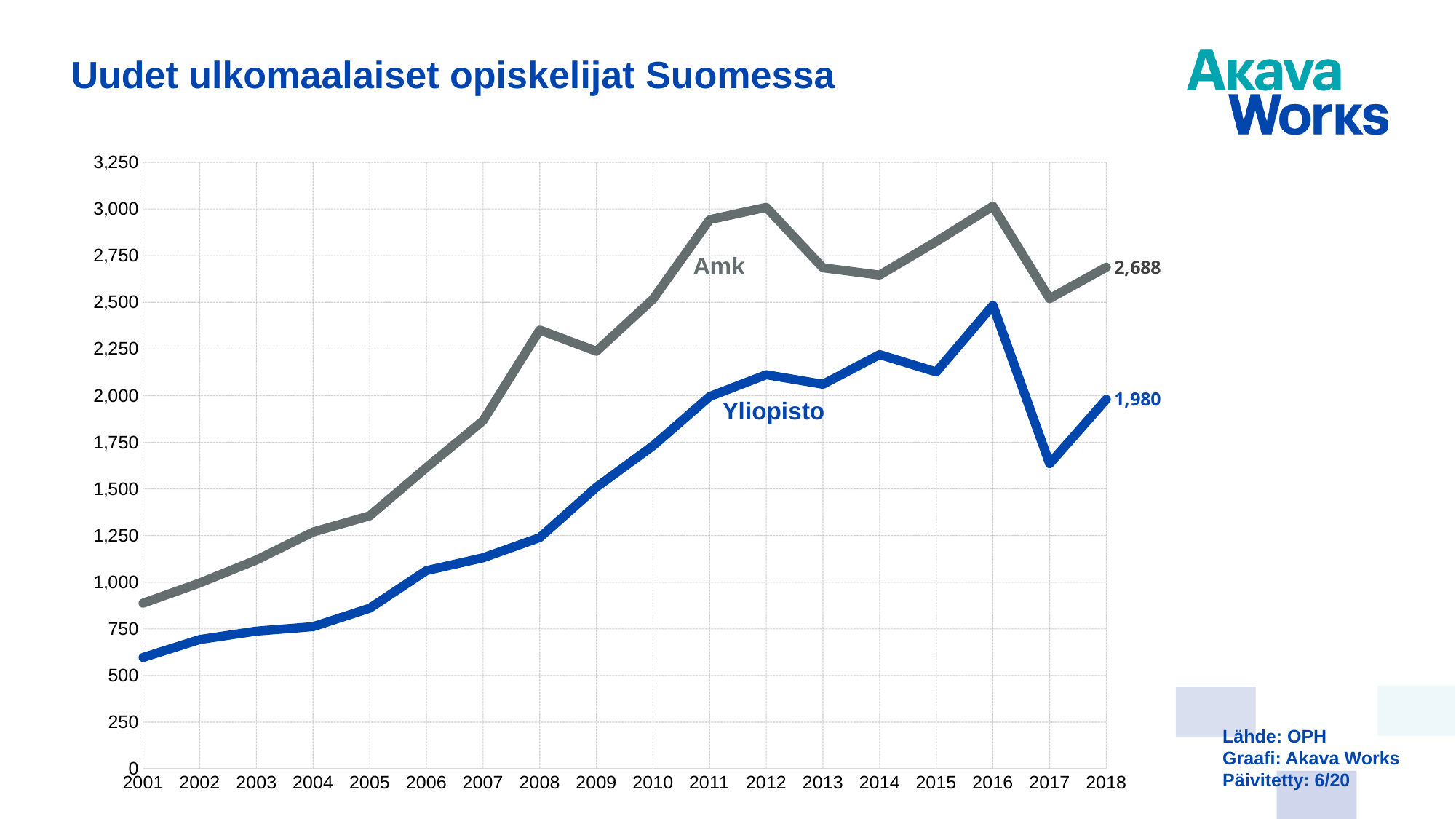
Is the value for Amk in 2001 greater or less than 1,000? less What kind of chart is shown on the slide? line chart In which year does the Yliopisto series reach its highest value? 2016 How many series are plotted on the chart? 2 Is the value for Yliopisto in 2017 greater or less than 1,500? greater What is the value for Yliopisto in 2018? 1,980 Is the value for Amk in 2008 greater or less than 2,250? greater In 2018, which series has the larger value, Amk or Yliopisto? Amk What is the value for Amk in 2018? 2,688 In which year is the Yliopisto series at its lowest value? 2001 How many years are shown on the x axis? 18 What is the difference between the Amk and Yliopisto values in 2018? 708